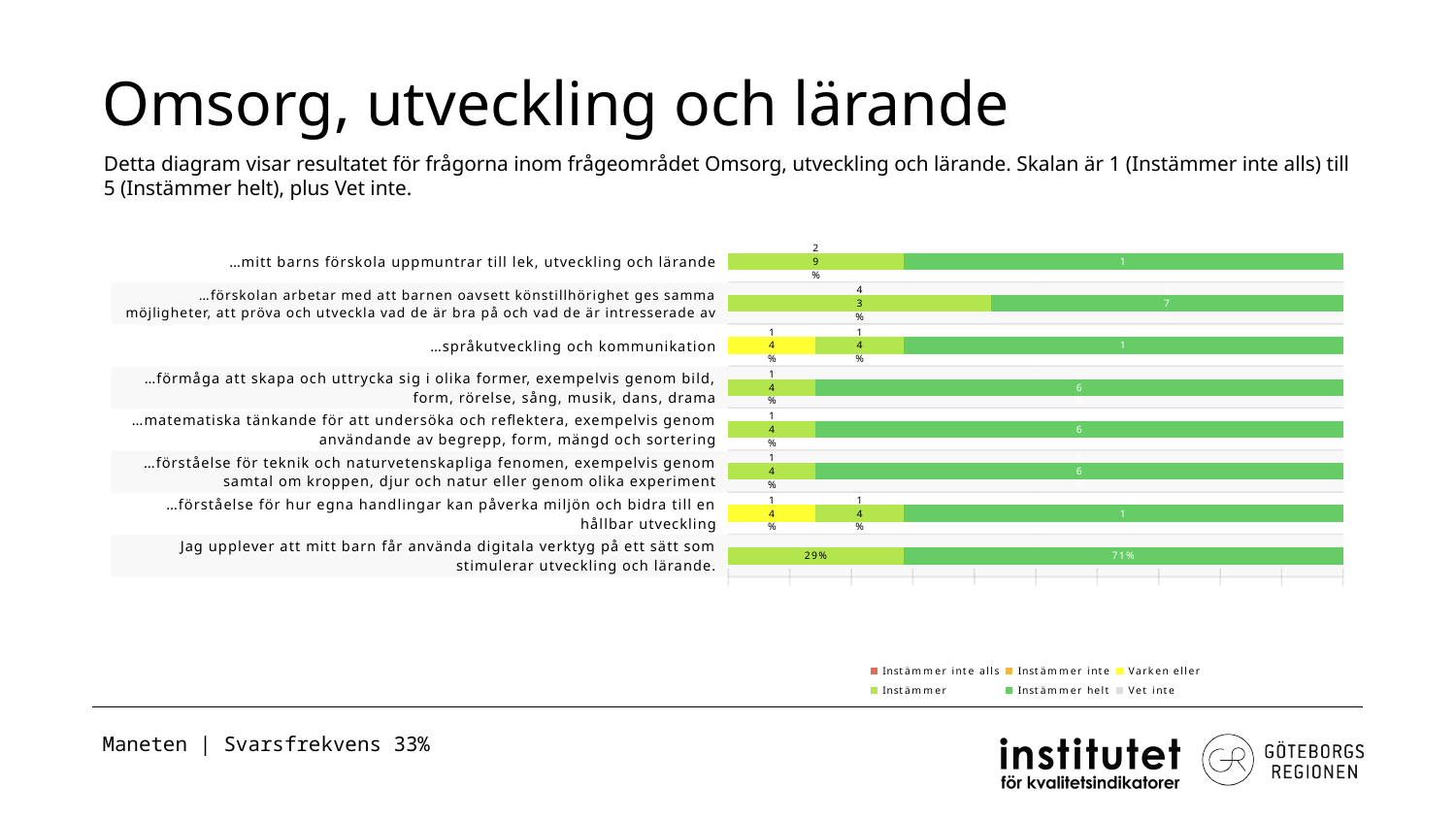
Which has the larger 'Instämmer helt' segment: '…förskolan arbetar med att barnen oavsett könstillhörighet ges samma möjligheter…' or 'Jag upplever att mitt barn får använda digitala verktyg…'? Jag upplever att mitt barn får använda digitala verktyg… For 'Jag upplever att mitt barn får använda digitala verktyg på ett sätt som stimulerar utveckling och lärande.', which is larger: 'Instämmer' or 'Instämmer helt'? Instämmer helt Which legend entry is shown in dark green? Instämmer helt What is the total of the bar for 'Jag upplever att mitt barn får använda digitala verktyg på ett sätt som stimulerar utveckling och lärande.'? 100% What is the difference between the 'Instämmer helt' and 'Instämmer' values for 'Jag upplever att mitt barn får använda digitala verktyg på ett sätt som stimulerar utveckling och lärande.'? 42% What is the 'Instämmer helt' value for 'Jag upplever att mitt barn får använda digitala verktyg på ett sätt som stimulerar utveckling och lärande.'? 71% What is the 'Instämmer' value for 'Jag upplever att mitt barn får använda digitala verktyg på ett sätt som stimulerar utveckling och lärande.'? 29% What is the title of the slide containing the chart? Omsorg, utveckling och lärande What kind of chart is shown on the slide? Stacked bar chart Which statement has the smallest 'Instämmer helt' segment? …förskolan arbetar med att barnen oavsett könstillhörighet ges samma möjligheter, att pröva och utveckla vad de är bra på och vad de är intresserade av How many question statements (categories) are plotted in the chart? 8 How many series does the legend list? 6